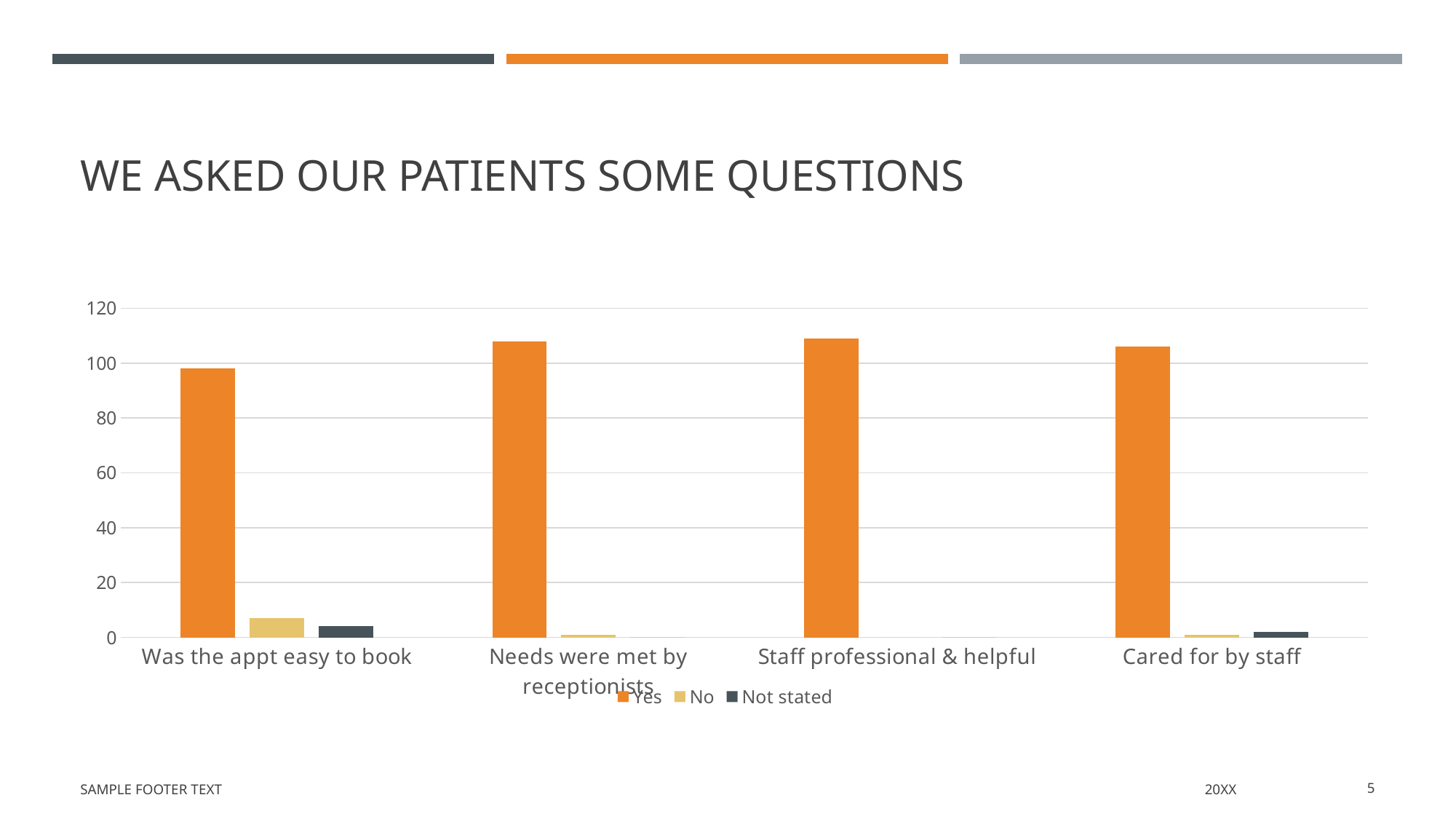
Which category has the highest 'No' value? Was the appt easy to book Which category has the lowest 'Yes' value? Was the appt easy to book How many question categories are shown on the x axis of the chart? 4 Is the 'Yes' value for 'Needs were met by receptionists' greater or less than 100? greater How many series does the chart's legend list? 3 Is the 'Yes' value for 'Was the appt easy to book' greater or less than 100? less Which is larger: the 'Yes' value for 'Was the appt easy to book' or the 'Yes' value for 'Cared for by staff'? Cared for by staff Is the 'No' value for 'Was the appt easy to book' greater or less than 20? less What is the title of the slide containing the chart? WE ASKED OUR PATIENTS SOME QUESTIONS What kind of chart is shown on the slide? bar chart Which series is shown in orange in the chart's legend? Yes